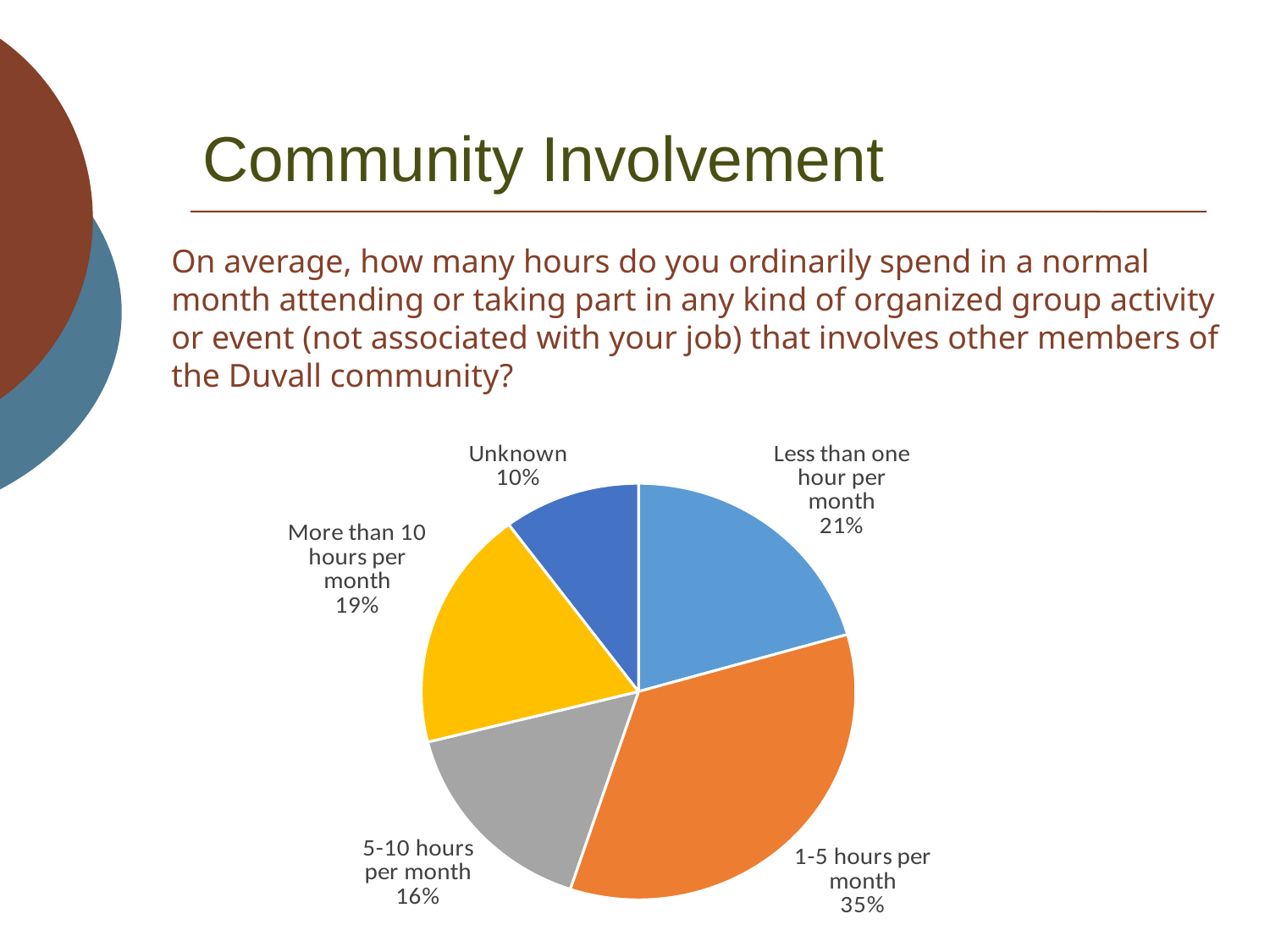
What share of respondents spend less than one hour per month? 21% What kind of chart is shown on the slide? pie chart Which category has the smallest slice of the pie? Unknown What share of respondents spend more than 10 hours per month? 19% What share of respondents spend 1-5 hours per month? 35% What share of respondents is labelled Unknown? 10% What colour is the 1-5 hours per month slice? orange What share of respondents spend 5-10 hours per month? 16% How many slices does the pie chart have? 5 Which category has the largest slice of the pie? 1-5 hours per month Which is larger: the share for less than one hour per month or the share for more than 10 hours per month? Less than one hour per month What is the difference in percentage points between the 1-5 hours per month slice and the 5-10 hours per month slice? 19